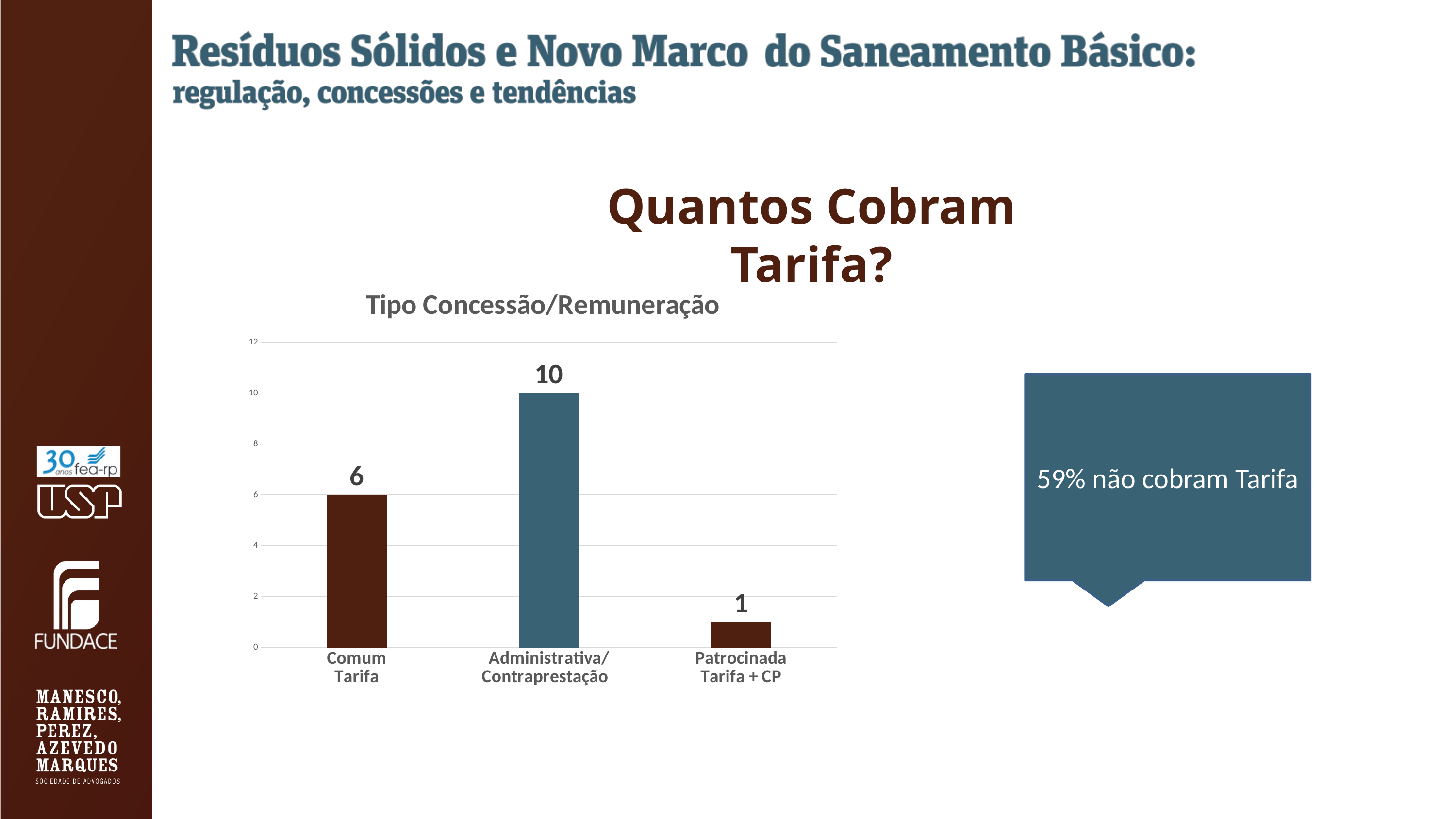
Which category has the highest value? Administrativa/Contraprestação What is the title of the chart? Tipo Concessão/Remuneração What is the difference between the values for Administrativa/Contraprestação and Comum Tarifa? 4 What is the value for Patrocinada Tarifa + CP? 1 Is the value for Administrativa/Contraprestação greater or less than 8? greater Which category has the lowest value? Patrocinada Tarifa + CP What is the difference between the values for Comum Tarifa and Patrocinada Tarifa + CP? 5 Which is larger, the value for Comum Tarifa or the value for Patrocinada Tarifa + CP? Comum Tarifa How many categories are shown on the x axis of the chart? 3 What is the value for Comum Tarifa? 6 What is the value for Administrativa/Contraprestação? 10 What kind of chart is shown on the slide? bar chart